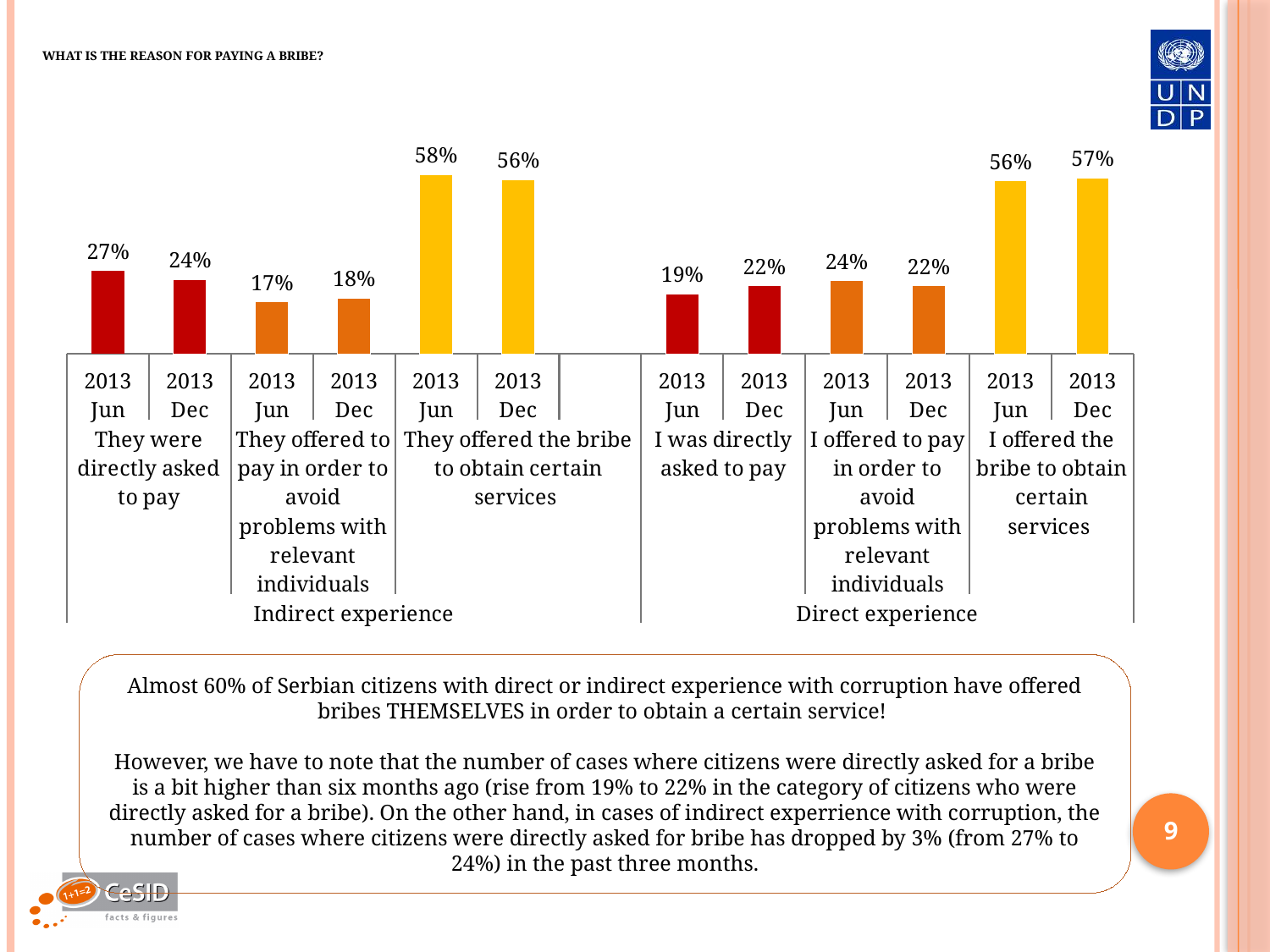
What is the value for 2013 Dec under "They offered to pay in order to avoid problems with relevant individuals" in the Indirect experience group? 18% What is the value for 2013 Jun under "They were directly asked to pay" in the Indirect experience group? 27% What is the difference between the 2013 Jun and 2013 Dec values for "They were directly asked to pay" in the Indirect experience group? 3% What is the difference between the 2013 Dec and 2013 Jun values for "I was directly asked to pay" in the Direct experience group? 3% What is the value for 2013 Jun under "I was directly asked to pay" in the Direct experience group? 19% Which bar has the highest value on the chart? 2013 Jun, They offered the bribe to obtain certain services (Indirect experience), 58% What is the value for 2013 Dec under "I offered the bribe to obtain certain services" in the Direct experience group? 57% How many bars are plotted on the chart? 12 Which bar has the lowest value on the chart? 2013 Jun, They offered to pay in order to avoid problems with relevant individuals (Indirect experience), 17% Which is larger: the 2013 Jun value for "I offered to pay in order to avoid problems with relevant individuals" or the 2013 Jun value for "I was directly asked to pay" in the Direct experience group? I offered to pay in order to avoid problems with relevant individuals (24%) What kind of chart is shown on the slide? Bar chart What are the two experience groups into which the chart's categories are divided? Indirect experience and Direct experience